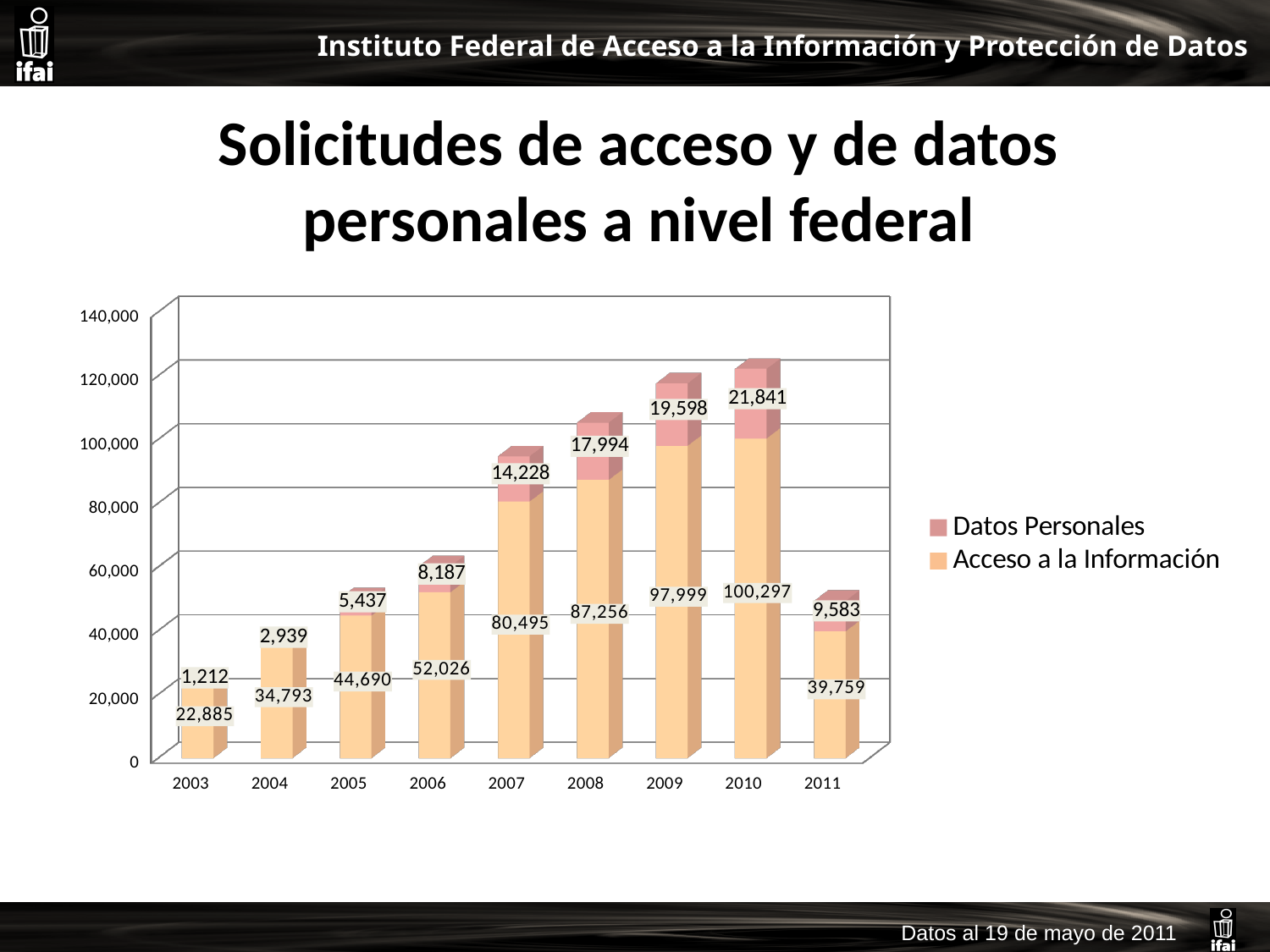
How many years are shown on the x axis? 9 Which year has the highest value for Acceso a la Información? 2010 What is the value of Datos Personales for 2010? 21,841 Which is larger, the Datos Personales value for 2011 or for 2006? 2011 What is the value of Acceso a la Información for 2007? 80,495 What kind of chart is shown on the slide? Stacked bar chart What is the value of Datos Personales for 2003? 1,212 Which year has the lowest value for Datos Personales? 2003 Which series is shown in pink in the legend? Datos Personales What is the total of the stacked bar for 2010? 122,138 How many series does the legend list? 2 What is the difference between the Acceso a la Información values for 2010 and 2009? 2,298